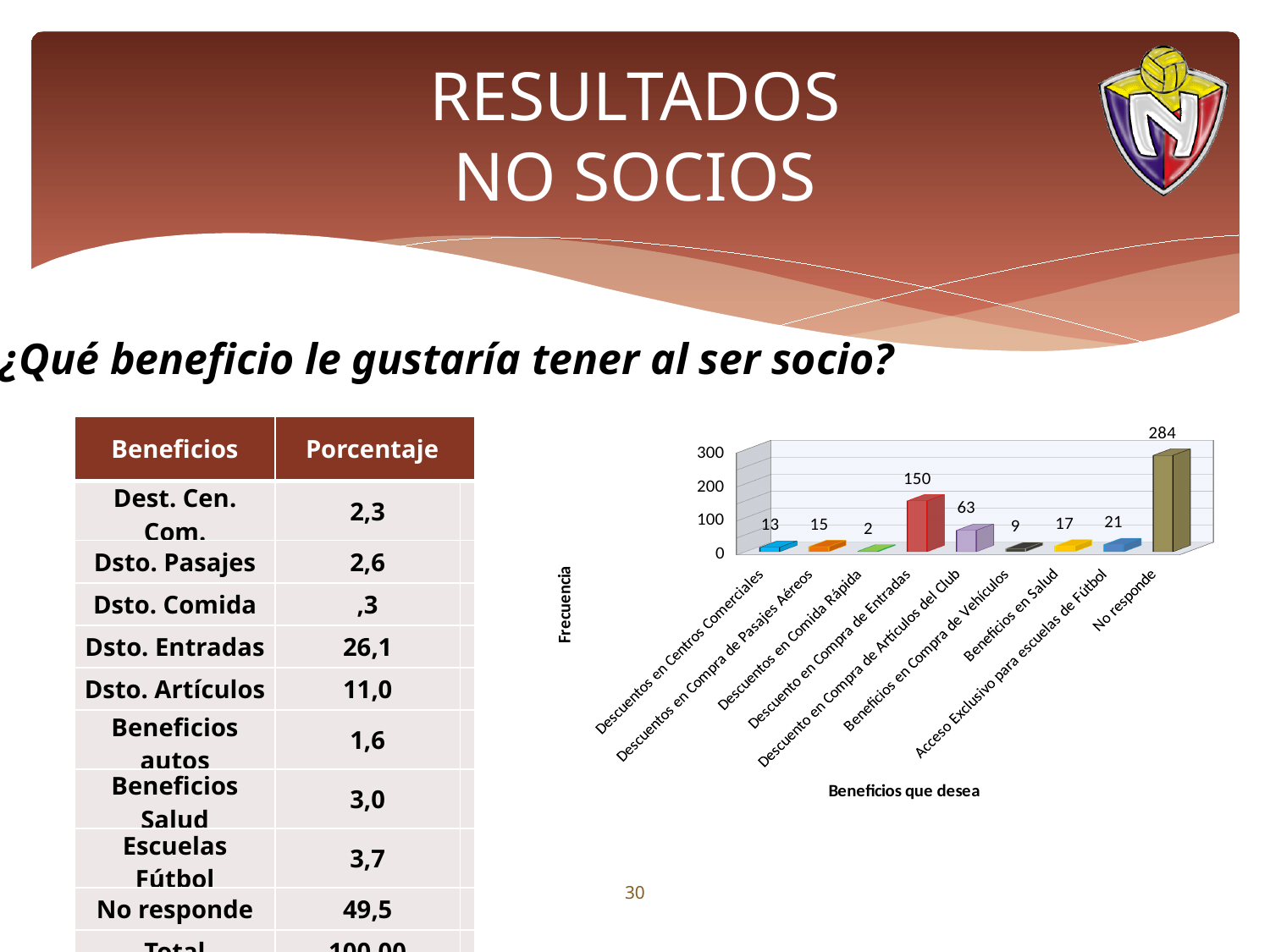
What is the frequency for 'Beneficios en Salud'? 17 Which has a higher frequency: 'Beneficios en Salud' or 'Acceso Exclusivo para escuelas de Fútbol'? Acceso Exclusivo para escuelas de Fútbol What is the frequency for 'Descuento en Compra de Artículos del Club'? 63 What type of chart is shown on the slide? Bar chart What is the difference in frequency between 'No responde' and 'Descuento en Compra de Entradas'? 134 How many categories are shown on the x axis of the chart? 9 Which category has the lowest frequency in the chart? Descuentos en Comida Rápida Which category has the highest frequency in the chart? No responde What is the title of the chart's horizontal axis? Beneficios que desea What is the frequency for 'No responde' in the chart? 284 What is the frequency for 'Descuento en Compra de Entradas'? 150 What is the title of the chart's vertical axis? Frecuencia